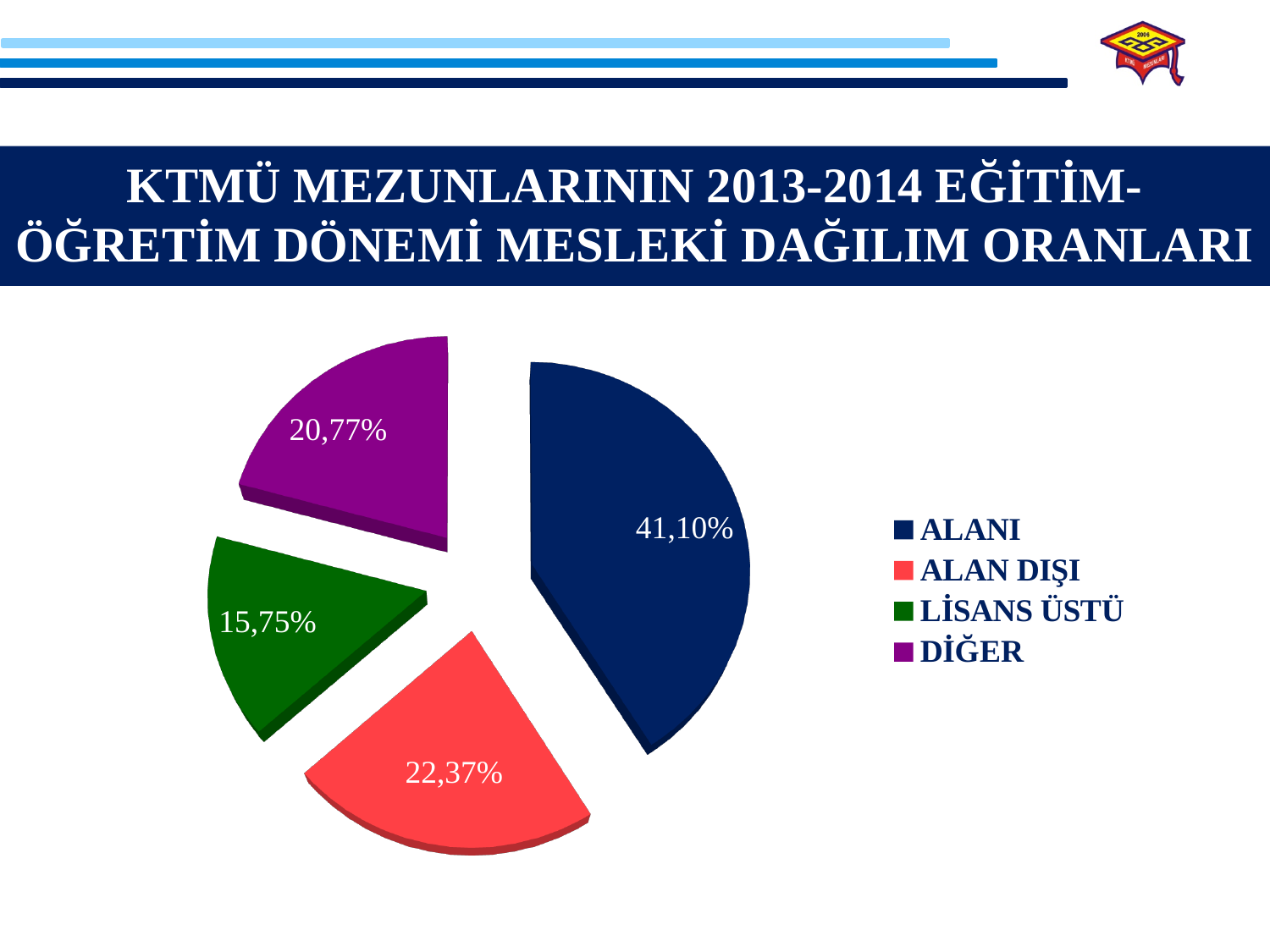
Which is larger, ALAN DIŞI or DİĞER? ALAN DIŞI What is the difference between the values for ALANI and ALAN DIŞI? 18,73% What colour is the slice for LİSANS ÜSTÜ? green How many slices does the pie chart have? 4 What is the value for LİSANS ÜSTÜ? 15,75% Which category has the smallest share of the pie? LİSANS ÜSTÜ What kind of chart is shown on the slide? pie chart Which category has the largest share of the pie? ALANI What is the value for ALAN DIŞI? 22,37% How many entries does the legend list? 4 What is the value for ALANI? 41,10% What is the value for DİĞER? 20,77%